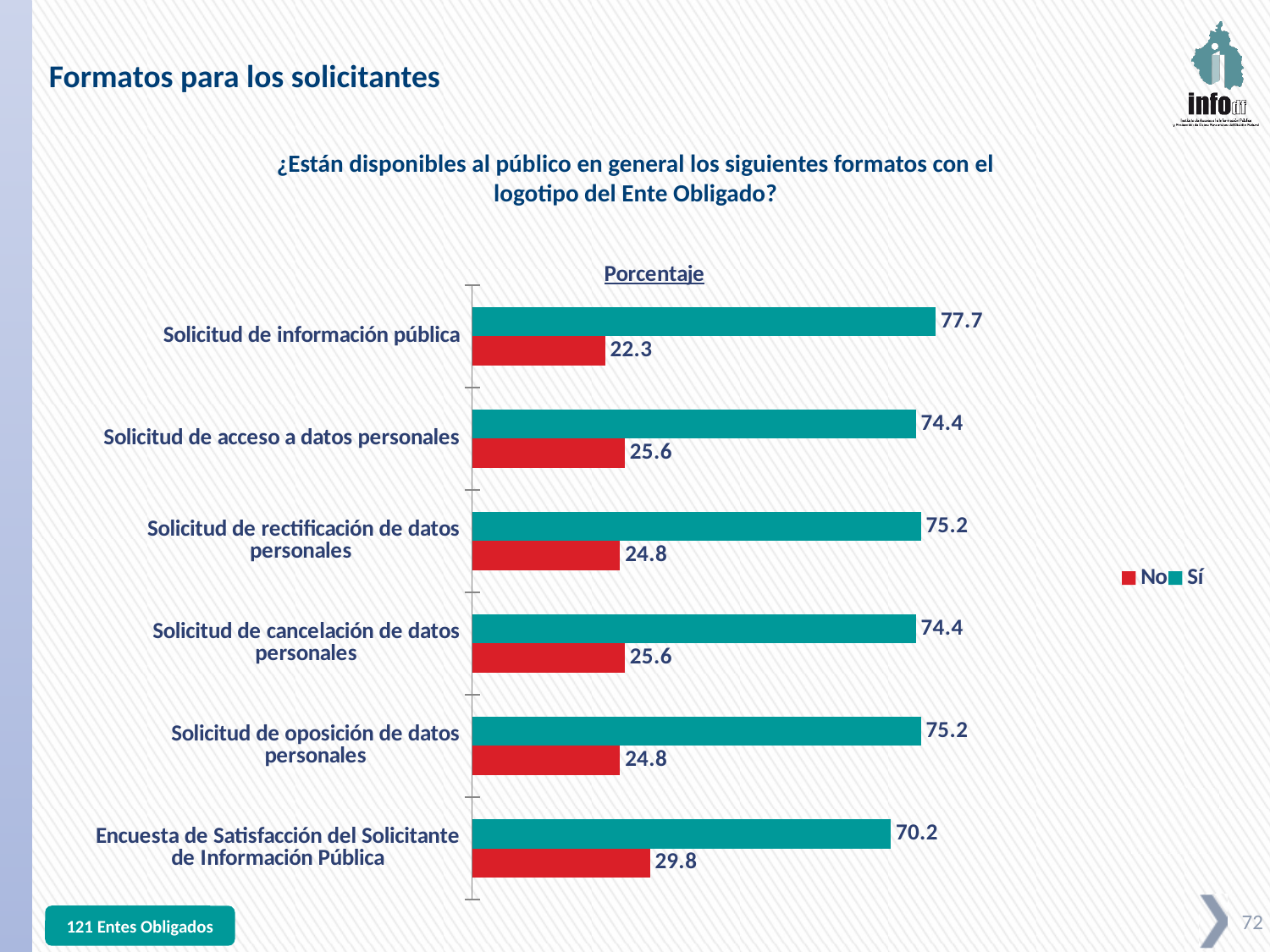
Which category has the lowest 'Sí' value? Encuesta de Satisfacción del Solicitante de Información Pública Which colour represents the 'No' series in the chart? Red What is the difference between the 'Sí' and 'No' values for 'Solicitud de rectificación de datos personales'? 50.4 What kind of chart is shown on the slide? Bar chart How many series does the legend list? 2 How many categories are shown in the chart? 6 Which is larger: the 'No' value for 'Solicitud de información pública' or the 'No' value for 'Solicitud de oposición de datos personales'? Solicitud de oposición de datos personales What is the 'Sí' value for 'Solicitud de información pública'? 77.7 What is the 'No' value for 'Solicitud de acceso a datos personales'? 25.6 Which category has the highest 'Sí' value? Solicitud de información pública What is the total of the 'Sí' and 'No' values for 'Solicitud de cancelación de datos personales'? 100 What is the 'No' value for 'Encuesta de Satisfacción del Solicitante de Información Pública'? 29.8